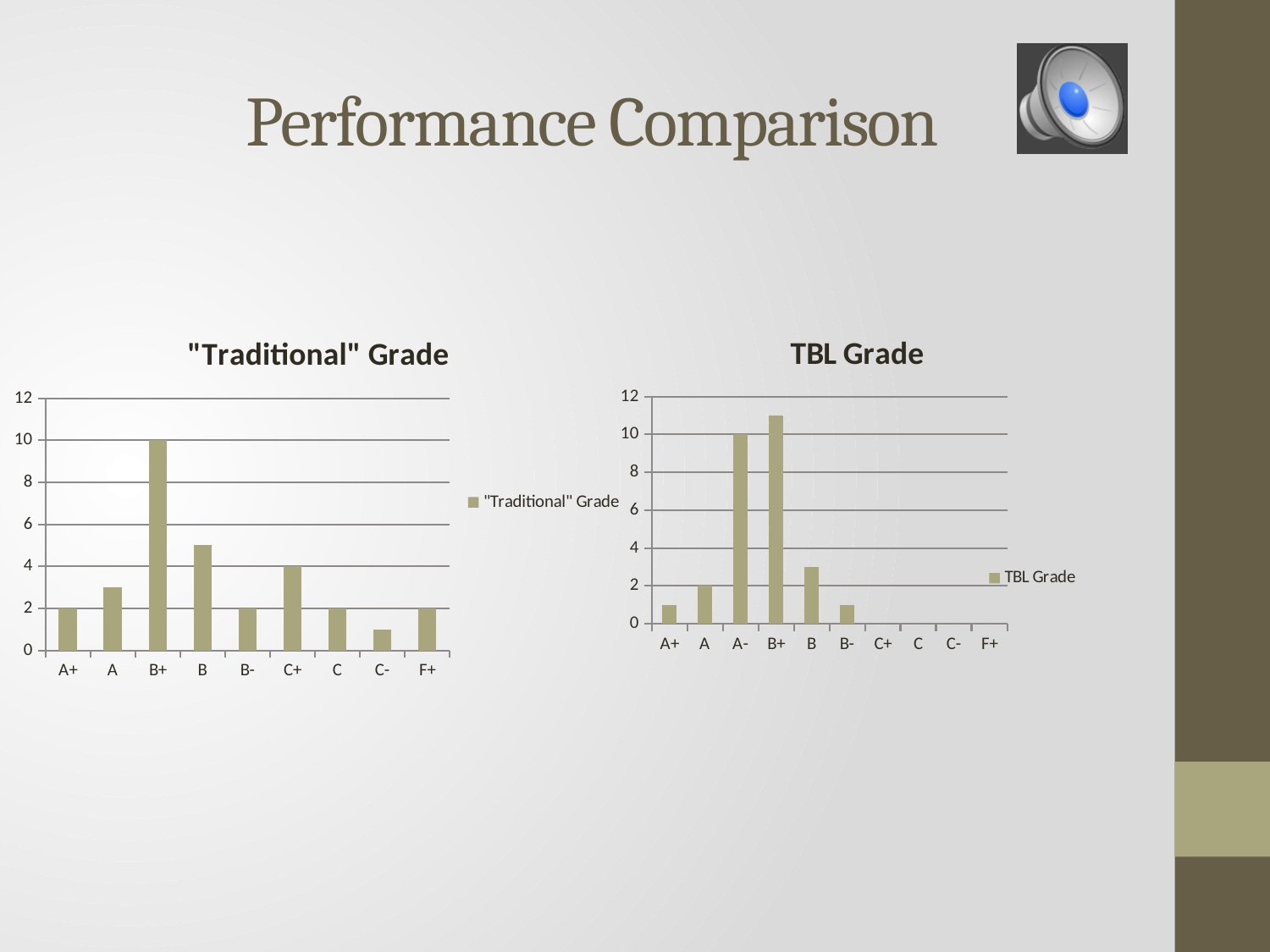
What kind of chart is the "Traditional" Grade chart? Bar chart In the "Traditional" Grade chart, which grade has the highest value? B+ In the TBL Grade chart, which grade has the highest value? B+ How many grade categories are shown on the x axis of the TBL Grade chart? 10 In the "Traditional" Grade chart, what is the value for B+? 10 In the "Traditional" Grade chart, what is the difference between the values for B+ and C+? 6 In the "Traditional" Grade chart, which grade has the lowest value? C- In the TBL Grade chart, what is the value for A-? 10 In the TBL Grade chart, what is the value for A? 2 In the "Traditional" Grade chart, what is the value for C+? 4 In the TBL Grade chart, is the value for B+ greater or less than 10? greater In the "Traditional" Grade chart, which is larger, the value for B or the value for A? B